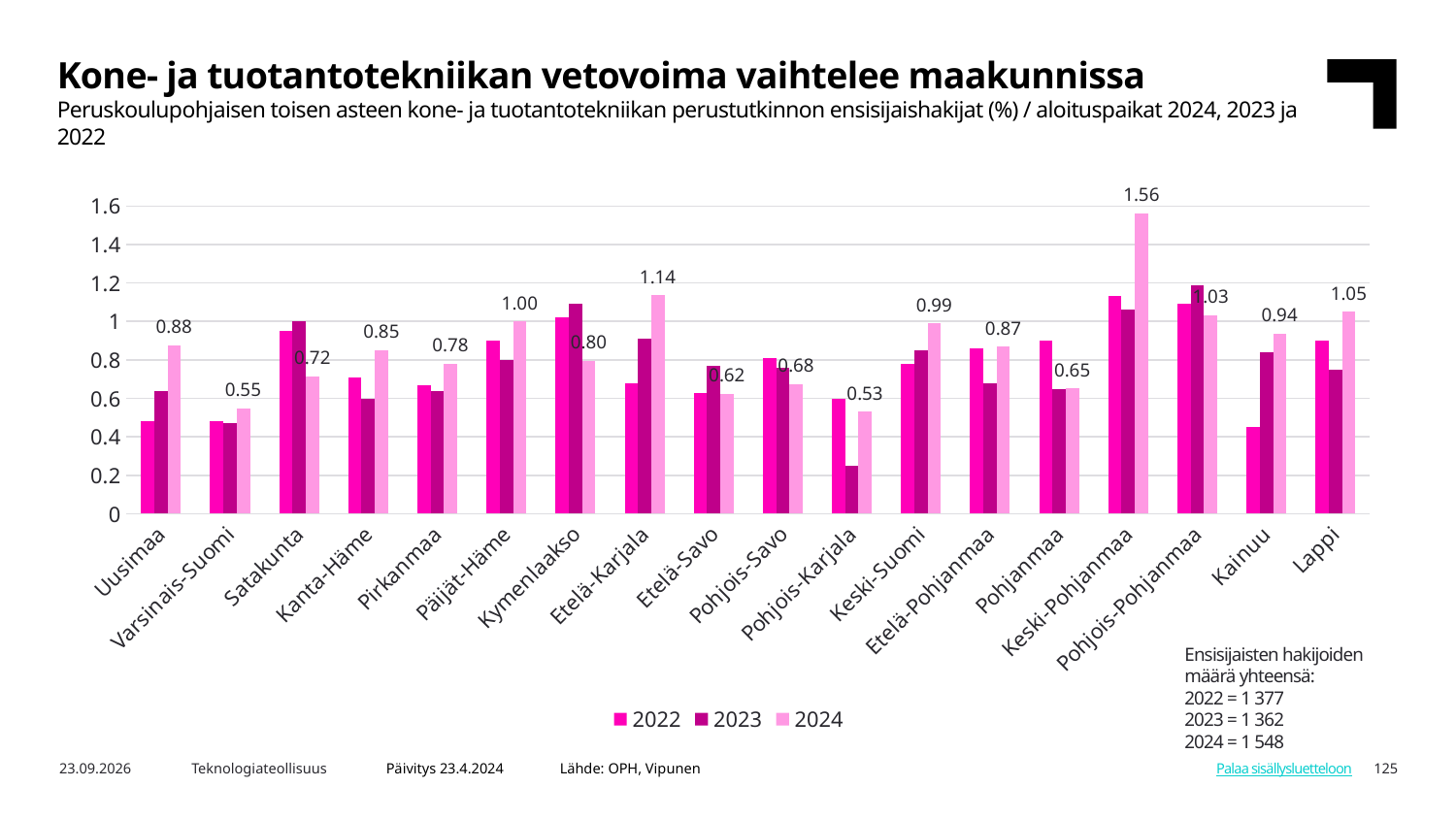
Which region has the highest 2024 value? Keski-Pohjanmaa Is the 2023 value for Pohjois-Karjala greater or less than 0.4? less How many series does the legend list? 3 What is the 2024 value for Etelä-Karjala? 1.14 How many regions are shown on the x axis? 18 Which region has the lowest 2024 value? Pohjois-Karjala What is the difference between the 2024 values for Keski-Pohjanmaa and Lappi? 0.51 Is the 2022 value for Satakunta greater or less than 0.8? greater What is the 2024 value for Pohjois-Karjala? 0.53 What kind of chart is shown on the slide? bar chart What is the 2024 value for Keski-Pohjanmaa? 1.56 Which is larger, the 2024 value for Kainuu or the 2024 value for Pohjanmaa? Kainuu